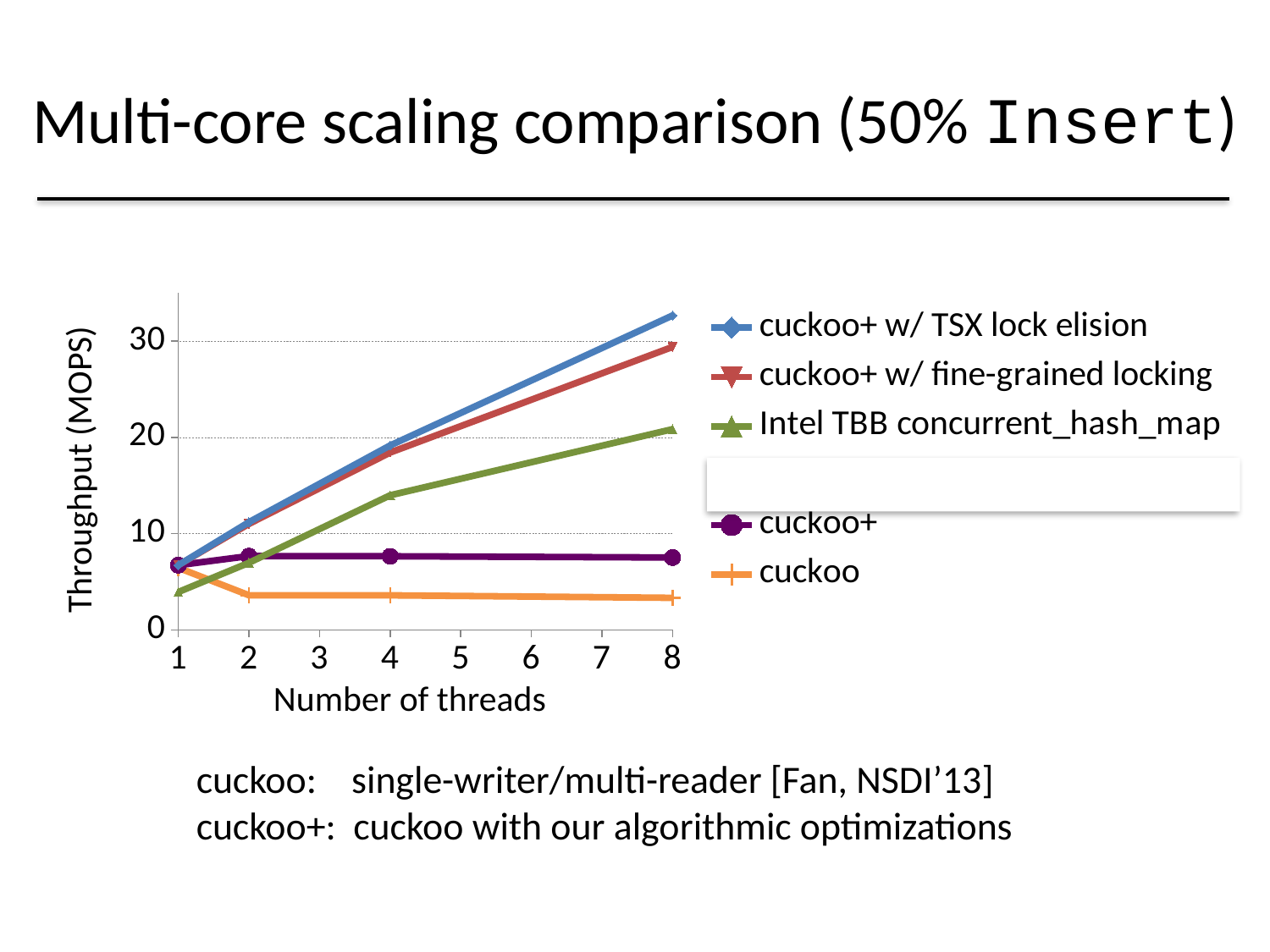
Which series has the lowest throughput at 8 threads? cuckoo What is the label of the y axis? Throughput (MOPS) Is the throughput of cuckoo+ w/ TSX lock elision at 8 threads greater or less than 30? greater Does the throughput of cuckoo+ w/ TSX lock elision rise or fall as the number of threads increases? rise What kind of chart is shown on the slide? line chart Which series has the highest throughput at 8 threads? cuckoo+ w/ TSX lock elision What is the label of the x axis? Number of threads Does the throughput of cuckoo fall or rise as the number of threads increases from 1 to 8? fall Is the throughput of Intel TBB concurrent_hash_map at 4 threads greater or less than 10? greater At 8 threads, which has higher throughput: Intel TBB concurrent_hash_map or cuckoo+? Intel TBB concurrent_hash_map How many series are listed in the chart's legend? 5 Is the throughput of cuckoo+ at 8 threads greater or less than 10? less